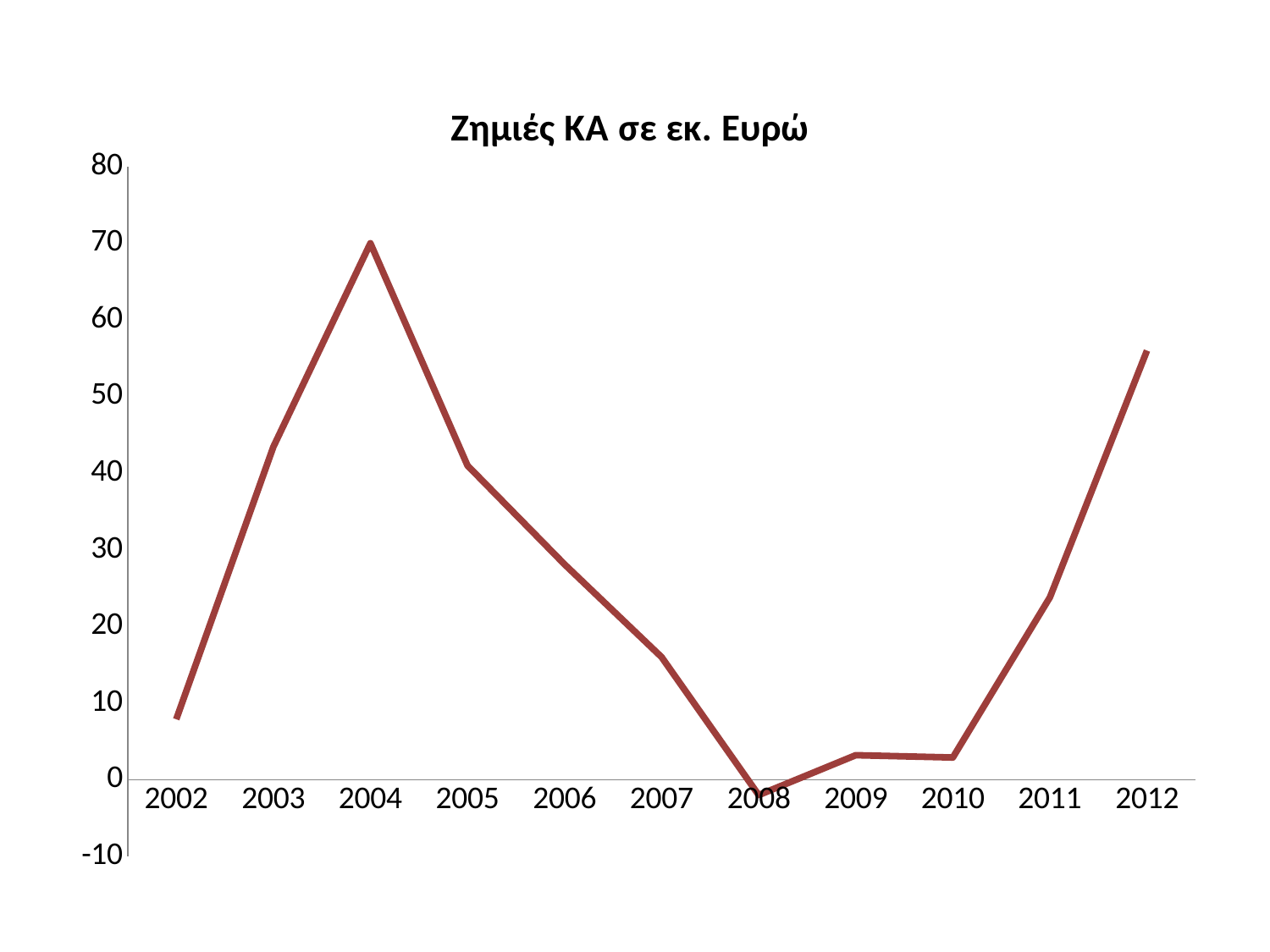
Is the value for 2007 greater or less than 20? less Is the value for 2004 greater or less than 60? greater Which is larger, the value for 2003 or the value for 2011? 2003 How many years are plotted along the x axis? 11 What is the title of the chart? Ζημιές ΚΑ σε εκ. Ευρώ Which is larger, the value for 2005 or the value for 2012? 2012 Do the values rise or fall from 2004 to 2008? fall What kind of chart is shown on the slide? line chart Is the value for 2002 greater or less than 10? less Which year has the lowest value? 2008 Which year has the highest value? 2004